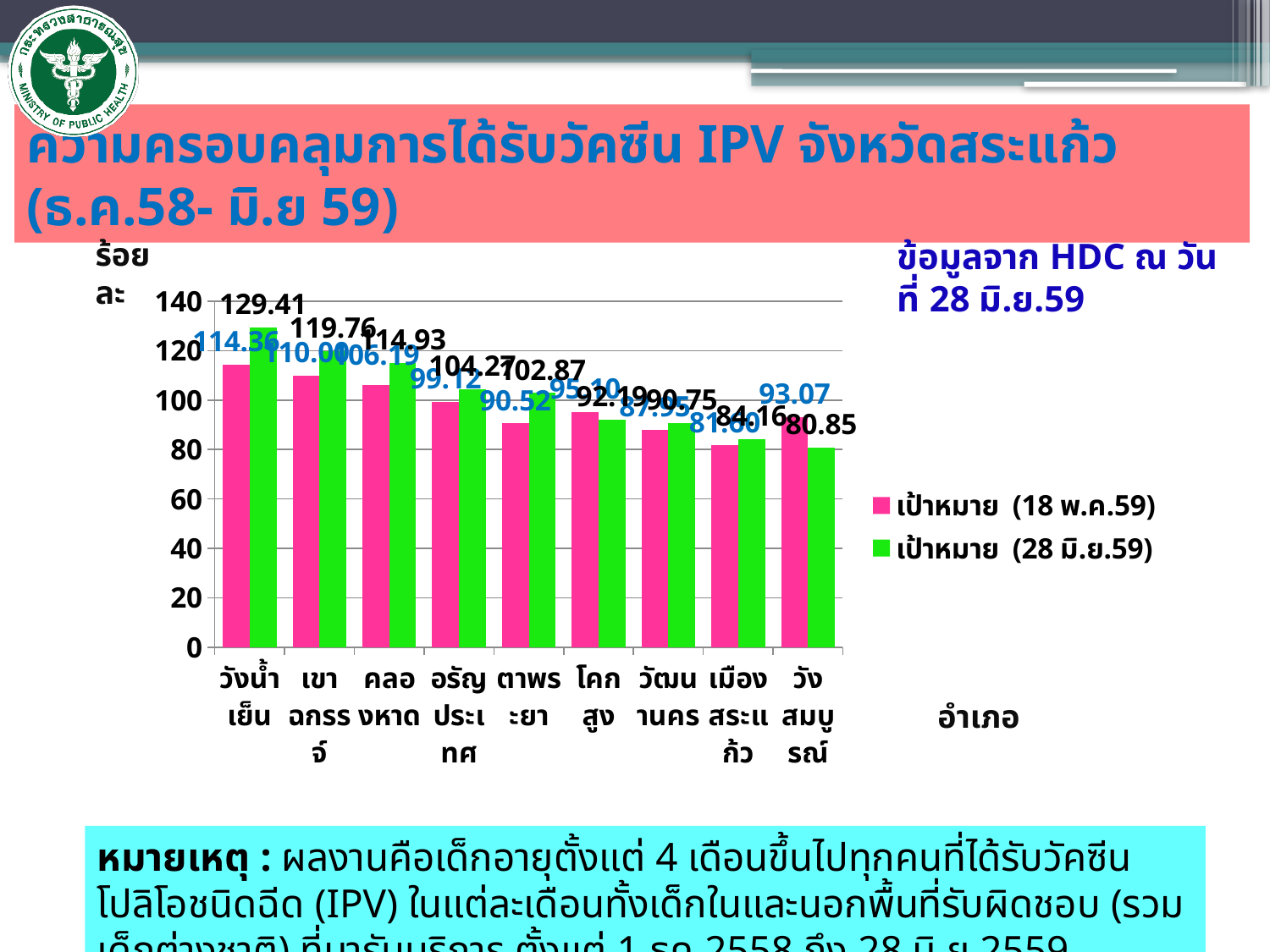
What is the value for วังสมบูรณ์ in the เป้าหมาย (18 พ.ค.59) series? 93.07 For วังสมบูรณ์, which series has the larger value: เป้าหมาย (18 พ.ค.59) or เป้าหมาย (28 มิ.ย.59)? เป้าหมาย (18 พ.ค.59) What is the difference between the เป้าหมาย (28 มิ.ย.59) and เป้าหมาย (18 พ.ค.59) values for วังน้ำเย็น? 15.05 How many series does the legend list? 2 What is the value for วังน้ำเย็น in the เป้าหมาย (18 พ.ค.59) series? 114.36 What kind of chart is shown on the slide? Bar chart Is the เป้าหมาย (28 มิ.ย.59) value for วังน้ำเย็น greater or less than 120? greater Which district has the highest value in the เป้าหมาย (28 มิ.ย.59) series? วังน้ำเย็น Which district has the lowest value in the เป้าหมาย (28 มิ.ย.59) series? วังสมบูรณ์ What is the value for เขาฉกรรจ์ in the เป้าหมาย (28 มิ.ย.59) series? 119.76 How many districts (อำเภอ) are shown on the x axis? 9 What is the value for วังน้ำเย็น in the เป้าหมาย (28 มิ.ย.59) series? 129.41